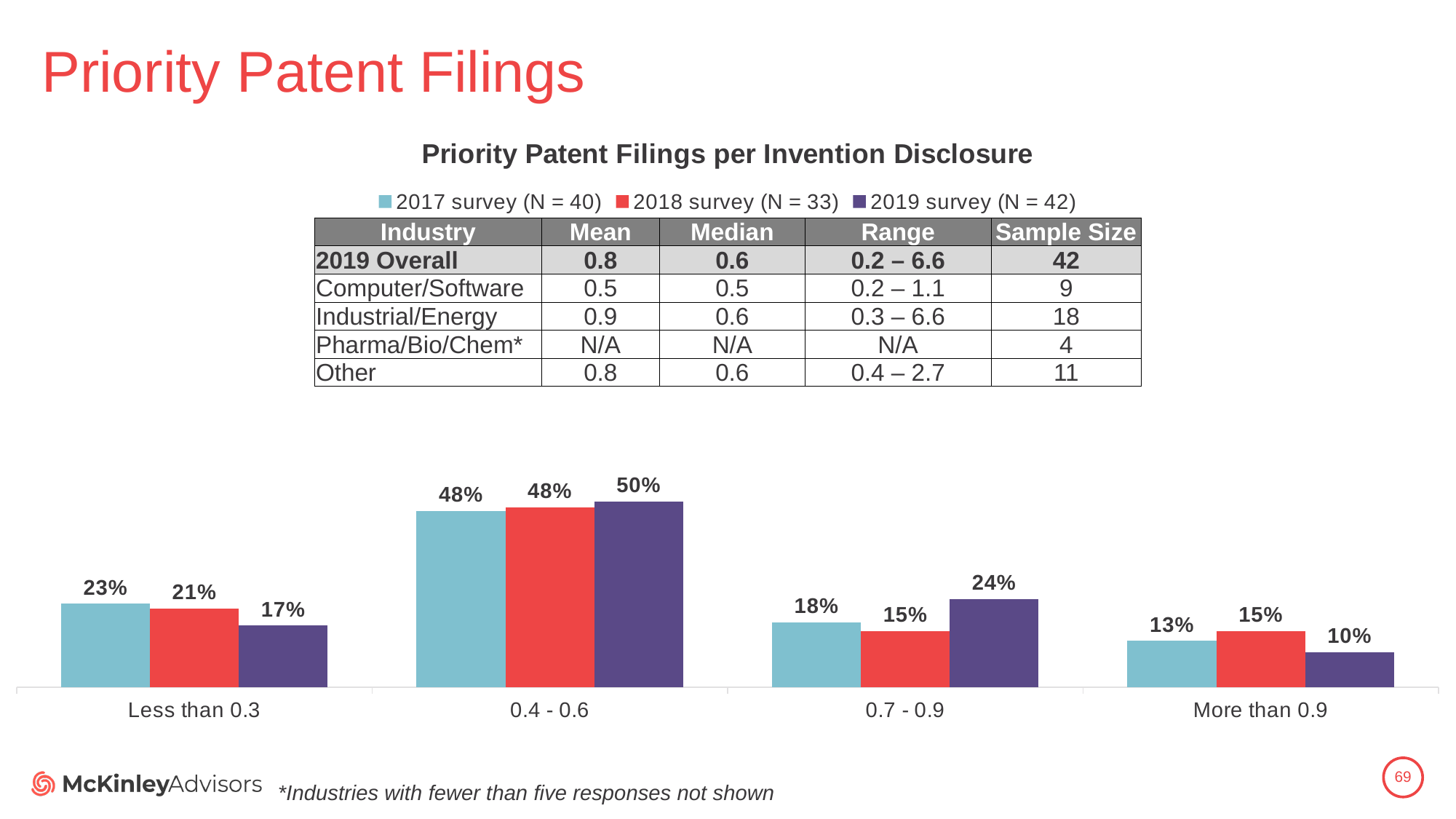
Which category has the highest value for the 2019 survey? 0.4 - 0.6 Which is larger in the Less than 0.3 category: the 2017 survey value or the 2019 survey value? 2017 survey How many categories are shown on the x axis of the chart? 4 What is the sample size for the 2018 survey according to the legend? 33 What is the value for the 2019 survey in the 0.4 - 0.6 category? 50% What is the value for the 2018 survey in the More than 0.9 category? 15% Which category has the lowest value for the 2017 survey? More than 0.9 What kind of chart is shown on the slide? Bar chart What is the difference between the 2019 survey and 2018 survey values in the 0.7 - 0.9 category? 9% How many series does the chart legend list? 3 What is the title of the chart? Priority Patent Filings per Invention Disclosure What is the value for the 2017 survey in the Less than 0.3 category? 23%